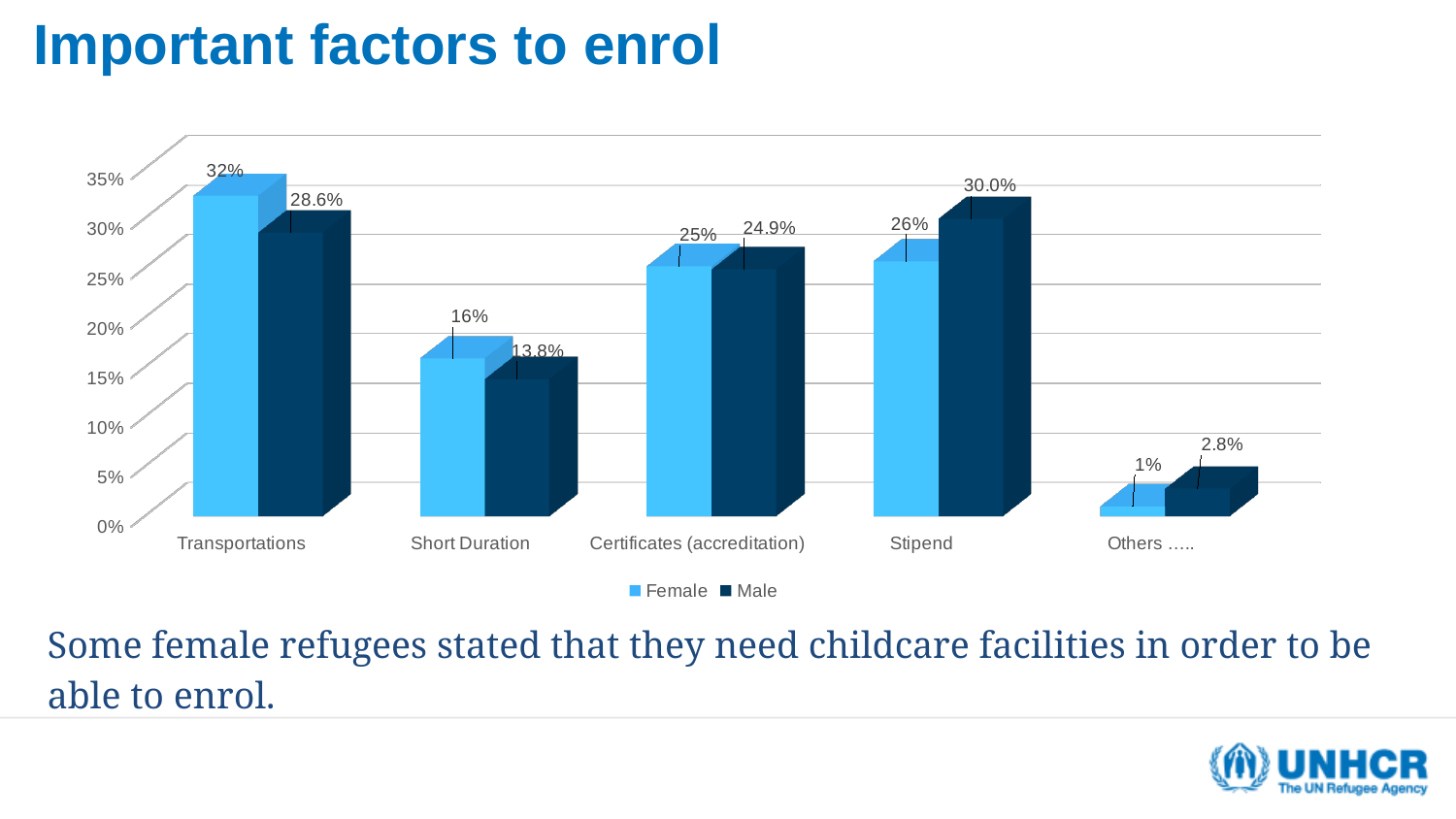
What is the difference between the Female and Male values for Transportations? 3.4% Is the Male value for Certificates (accreditation) greater or less than 20%? greater What is the Female value for Transportations? 32% How many series does the legend list? 2 What is the Male value for Stipend? 30.0% For Stipend, which is larger, the Female value or the Male value? Male Which category has the lowest Male value? Others ….. What is the Male value for Short Duration? 13.8% What kind of chart is shown on the slide? Bar chart What is the Female value for Others …..? 1% How many categories are shown on the x axis? 5 Which category has the highest Female value? Transportations